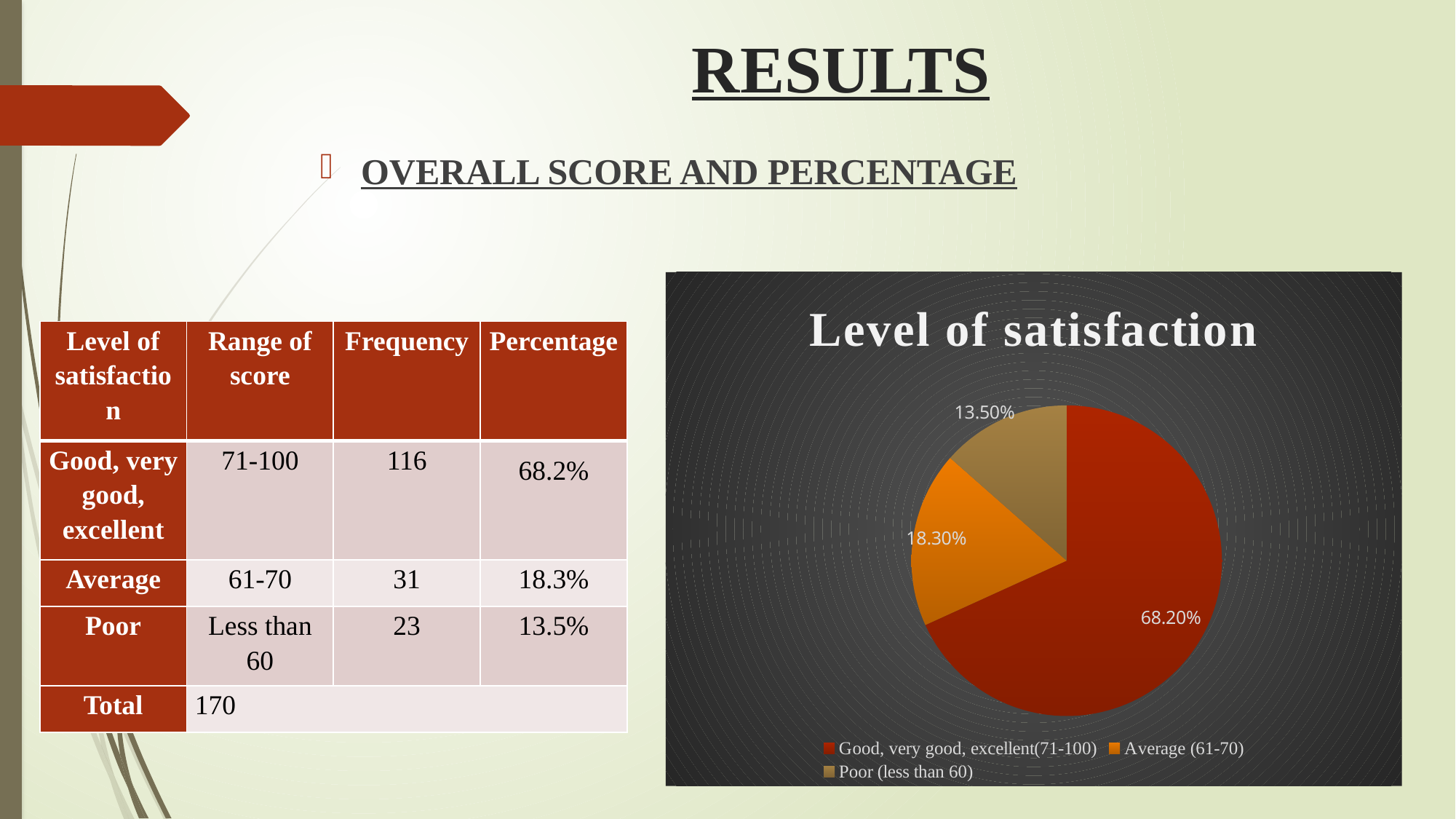
How many slices does the pie chart have? 3 Which slice is larger: Average (61-70) or Poor (less than 60)? Average (61-70) What type of chart is shown on the slide? pie chart What colour is the slice for Average (61-70)? orange What percentage does the chart show for Poor (less than 60)? 13.50% Which category has the smallest slice of the pie? Poor (less than 60) How many entries does the chart legend list? 3 What is the title of the chart? Level of satisfaction What percentage does the chart show for Good, very good, excellent(71-100)? 68.20% What percentage does the chart show for Average (61-70)? 18.30% Which category has the largest slice of the pie? Good, very good, excellent(71-100) What is the difference in percentage points between the Average (61-70) slice and the Poor (less than 60) slice? 4.80%